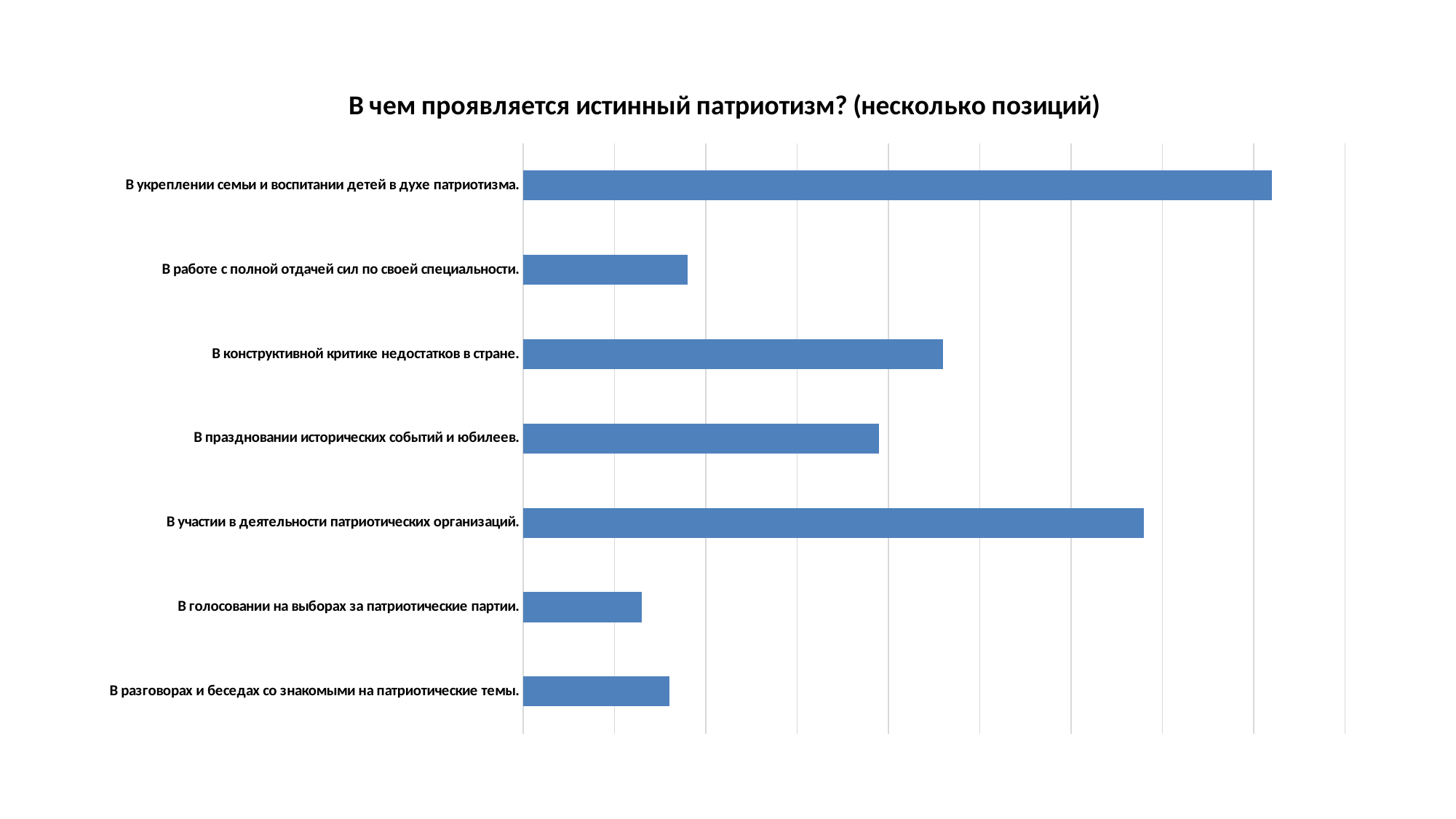
Which category has the highest value? В укреплении семьи и воспитании детей в духе патриотизма. Which category has the second-highest value? В участии в деятельности патриотических организаций. Which category has the lowest value? В голосовании на выборах за патриотические партии. Which is larger: the value for "В укреплении семьи и воспитании детей в духе патриотизма." or the value for "В участии в деятельности патриотических организаций."? В укреплении семьи и воспитании детей в духе патриотизма. What kind of chart is shown on the slide? Bar chart How many categories are plotted in the chart? 7 Which is larger: the value for "В участии в деятельности патриотических организаций." or the value for "В работе с полной отдачей сил по своей специальности."? В участии в деятельности патриотических организаций. Which is larger: the value for "В разговорах и беседах со знакомыми на патриотические темы." or the value for "В голосовании на выборах за патриотические партии."? В разговорах и беседах со знакомыми на патриотические темы. What is the title of the chart? В чем проявляется истинный патриотизм? (несколько позиций) What colour are the bars in the chart? Blue